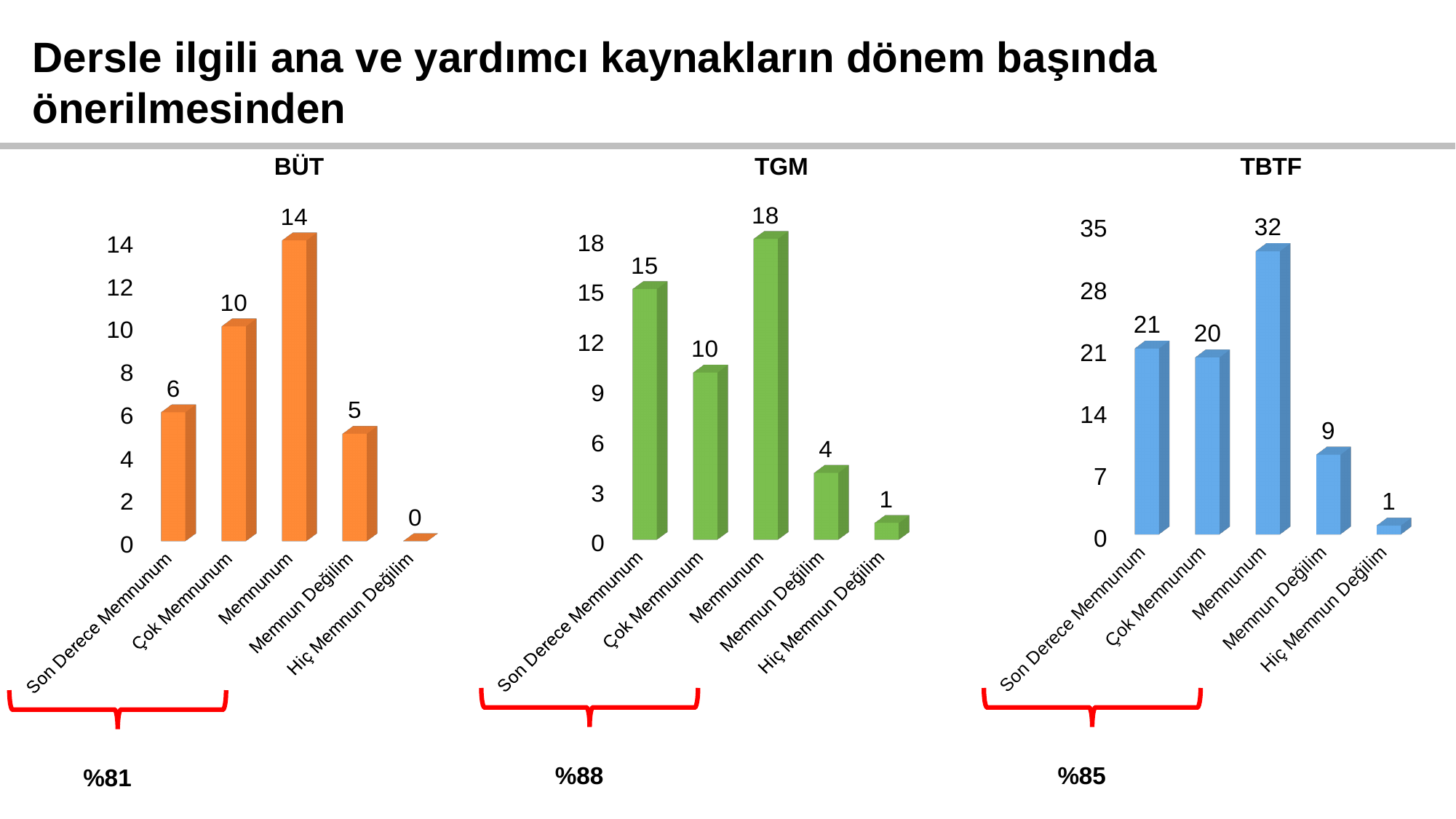
In the BÜT chart, what is the difference between Çok Memnunum and Son Derece Memnunum? 4 What type of chart is the BÜT chart? bar chart What colour are the bars in the TGM chart? green How many charts are on the slide? 3 In the BÜT chart, what is the value for Memnunum? 14 In the BÜT chart, which category has the lowest value? Hiç Memnun Değilim In the TBTF chart, which category has the highest value? Memnunum In the TGM chart, what is the difference between Memnunum and Çok Memnunum? 8 How many categories are shown in the TGM chart? 5 In the TBTF chart, what is the value for Memnun Değilim? 9 In the TGM chart, what is the value for Son Derece Memnunum? 15 In the TBTF chart, which is larger, Son Derece Memnunum or Çok Memnunum? Son Derece Memnunum